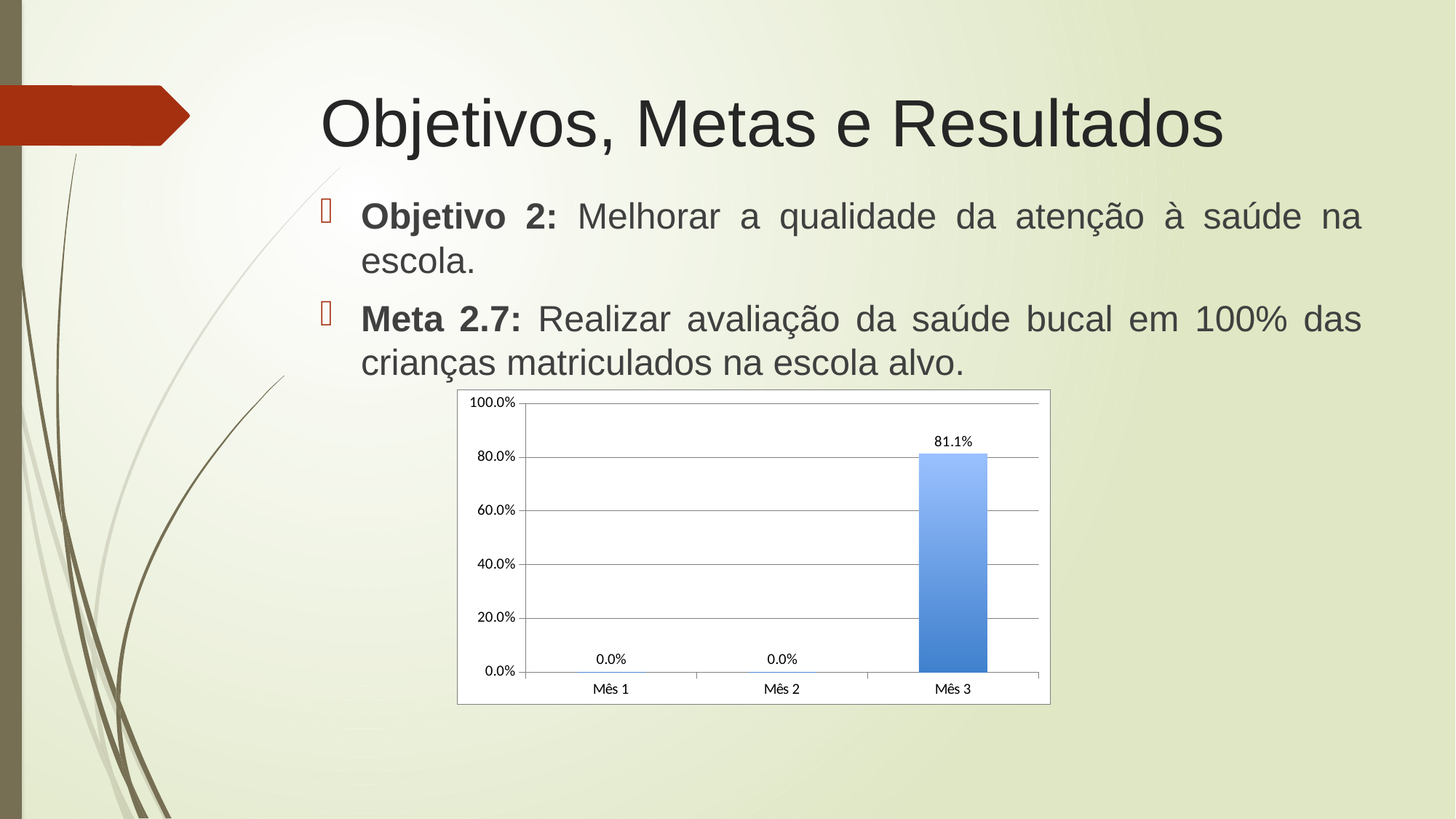
What is the value for Mês 1? 0.0% How many categories are shown on the x axis? 3 Is the value for Mês 3 greater or less than 100.0%? less Do the values rise or fall from Mês 1 to Mês 3? rise What is the highest tick value shown on the y axis? 100.0% Which is larger, the value for Mês 1 or the value for Mês 3? Mês 3 What is the difference between the values for Mês 3 and Mês 2? 81.1% Which category has the highest value? Mês 3 Is the value for Mês 3 greater or less than 80.0%? greater What kind of chart is shown on the slide? bar chart What is the value for Mês 2? 0.0% What is the value for Mês 3? 81.1%